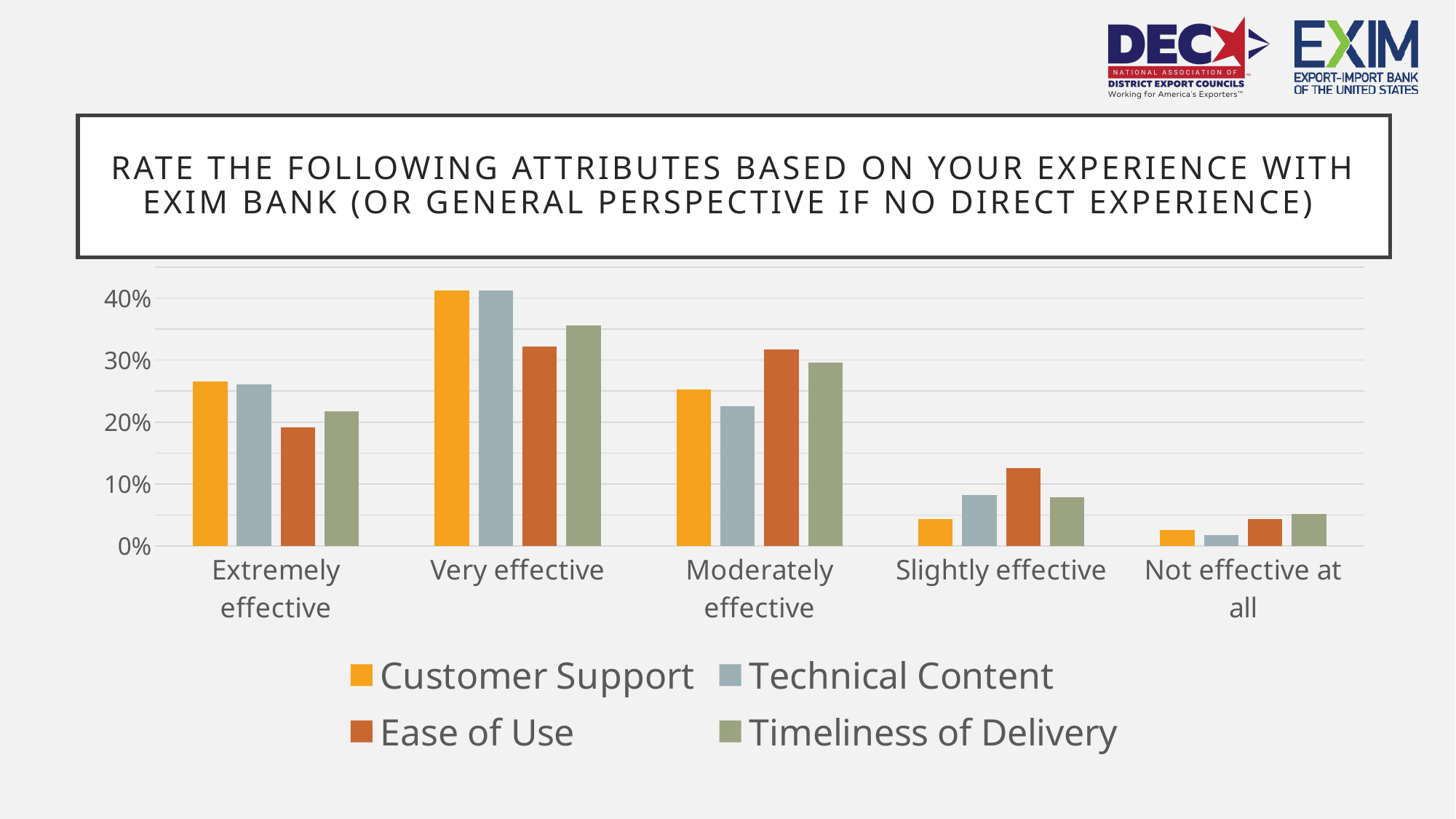
How many rating categories are shown along the x axis? 5 In the Moderately effective category, which is larger: Ease of Use or Customer Support? Ease of Use Is the value for Technical Content in the Moderately effective category greater or less than 20%? greater Which category has the lowest value for Technical Content? Not effective at all What kind of chart is shown on the slide? Bar chart Is the value for Timeliness of Delivery in the Very effective category greater or less than 30%? greater In the Slightly effective category, which series has the highest value? Ease of Use Is the value for Ease of Use in the Slightly effective category greater or less than 10%? greater Which category has the highest value for Customer Support? Very effective How many series does the legend list? 4 What colour represents Customer Support in the legend? Orange